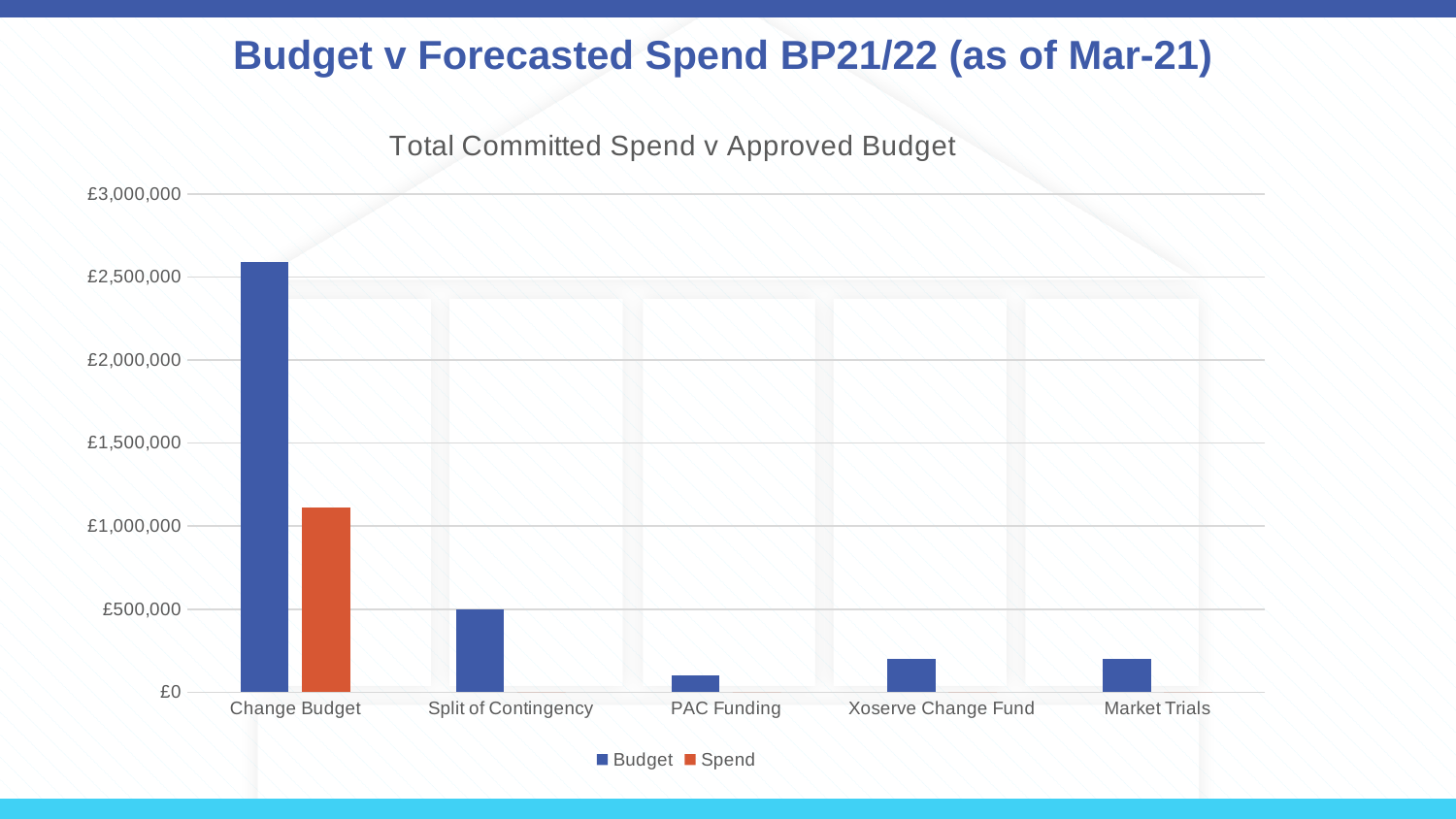
Is the Spend value for Change Budget greater or less than £1,000,000? greater Is the Budget value for PAC Funding greater or less than £500,000? less Which category has the lowest Budget value? PAC Funding Which category has the highest Budget value? Change Budget How many categories are shown on the x axis? 5 Is the Budget value for Xoserve Change Fund greater or less than £500,000? less For Change Budget, which is larger, the Budget value or the Spend value? Budget What is the title of the chart? Total Committed Spend v Approved Budget Which colour represents the Spend series in the legend? Orange How many series does the legend list? 2 What kind of chart is shown on the slide? Bar chart